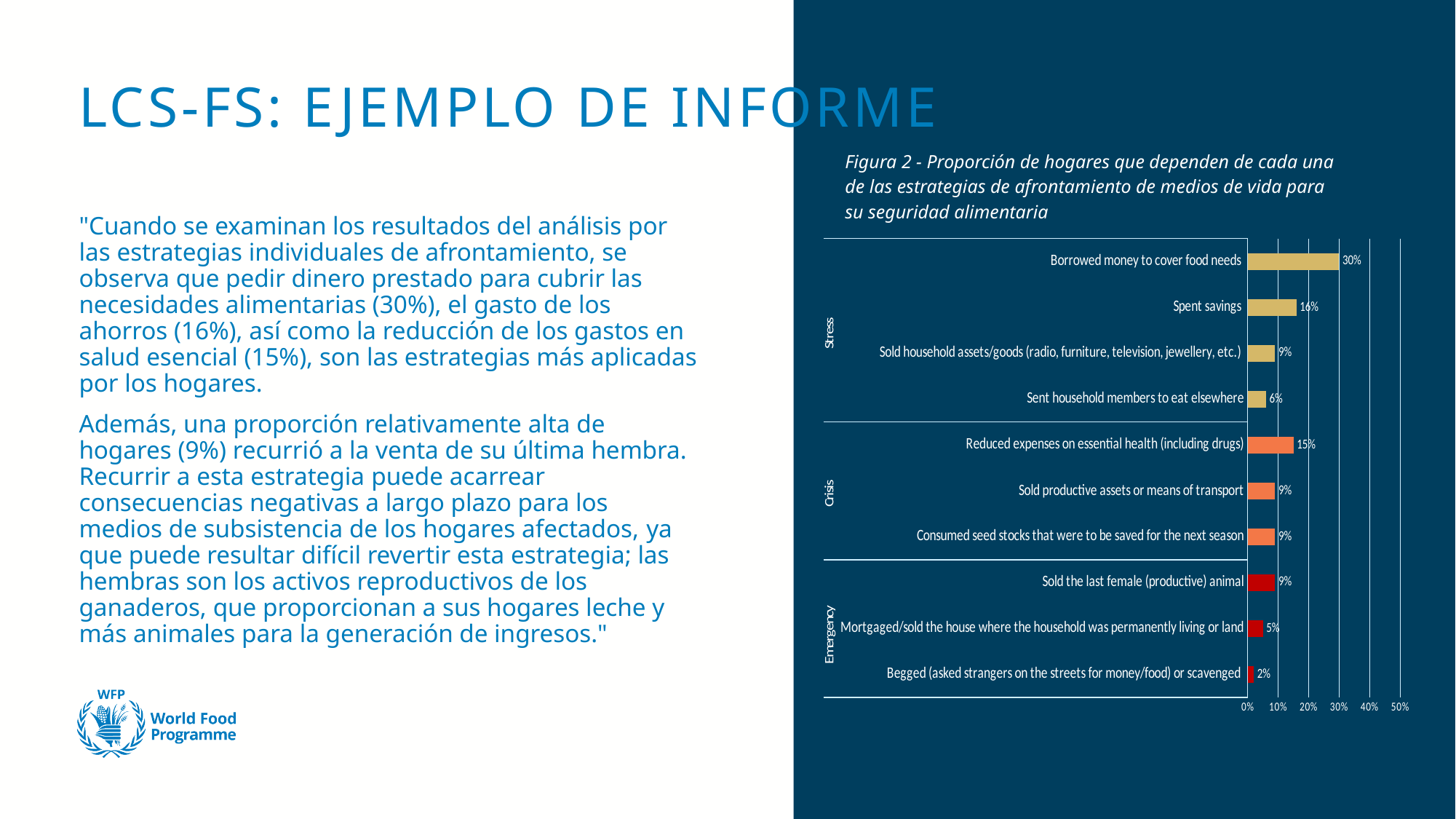
Which category has the highest value? Borrowed money to cover food needs What is the value for 'Sent household members to eat elsewhere'? 6% What are the three groups the categories are divided into on the vertical axis? Stress, Crisis, Emergency How many categories (bars) are shown in the chart? 10 Which is larger: 'Spent savings' or 'Reduced expenses on essential health (including drugs)'? Spent savings What is the value for 'Spent savings'? 16% What is the difference between 'Borrowed money to cover food needs' and 'Spent savings'? 14% Which category has the lowest value? Begged (asked strangers on the streets for money/food) or scavenged What is the value for 'Begged (asked strangers on the streets for money/food) or scavenged'? 2% What is the value for 'Borrowed money to cover food needs'? 30% What is the value for 'Reduced expenses on essential health (including drugs)'? 15% What kind of chart is shown? Bar chart